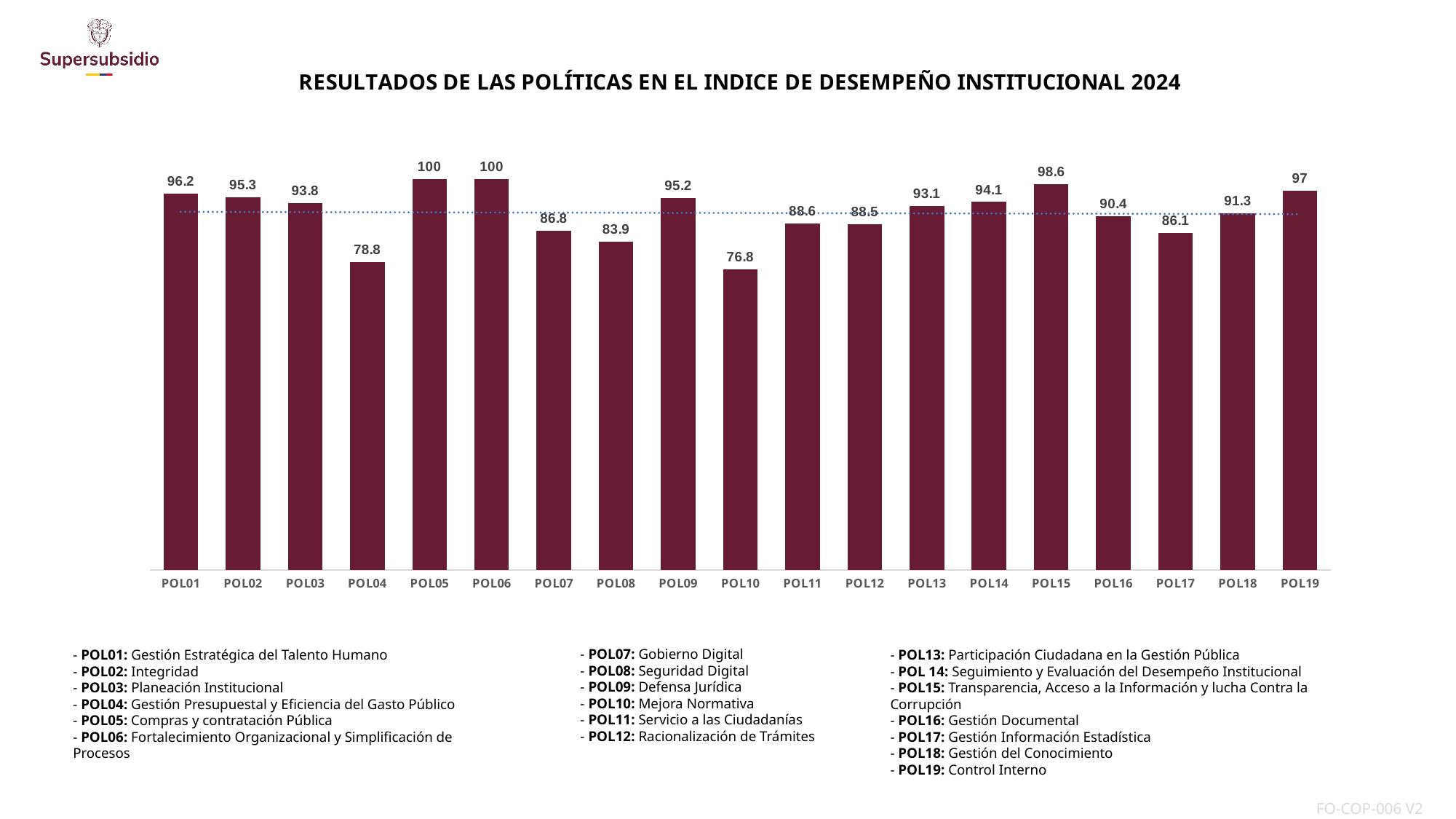
What kind of chart is shown on the slide? Bar chart Which is larger, the value for POL09 or the value for POL13? POL09 What is the value for POL04? 78.8 What is the value for POL19? 97 What is the difference between the values for POL01 and POL10? 19.4 What is the title of the chart? RESULTADOS DE LAS POLÍTICAS EN EL INDICE DE DESEMPEÑO INSTITUCIONAL 2024 Which is larger, the value for POL04 or the value for POL08? POL08 Which categories share the highest value of 100? POL05 and POL06 What is the value for POL15? 98.6 Which category has the lowest value? POL10 How many categories are shown on the x axis? 19 What is the difference between the values for POL15 and POL17? 12.5